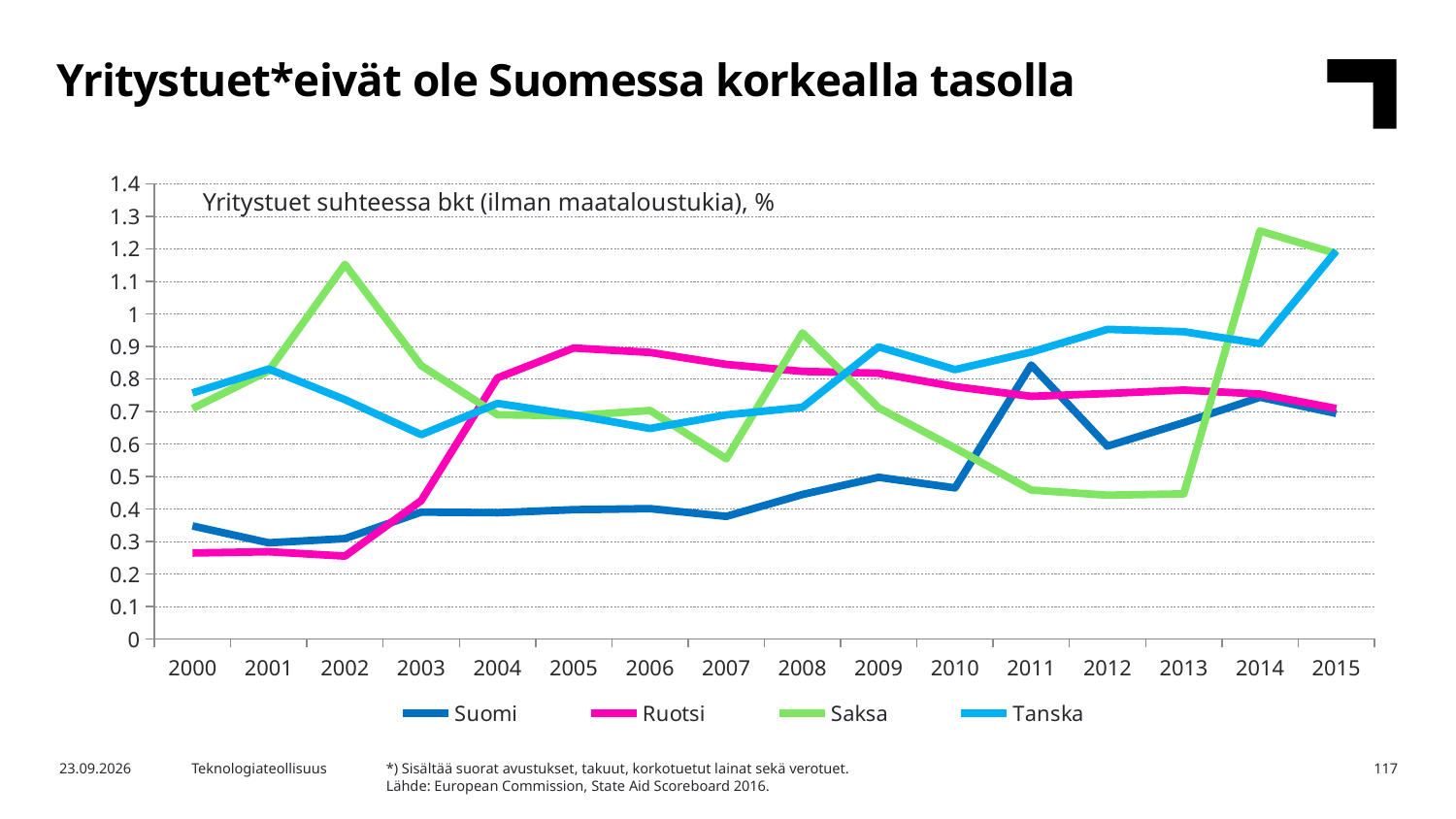
What is the title printed inside the chart area? Yritystuet suhteessa bkt (ilman maataloustukia), % How many series does the legend list? 4 What kind of chart is shown on the slide? Line chart Is the value for Saksa in 2002 greater or less than 1? greater Is the value for Suomi in 2000 greater or less than 0.5? less Which colour is used for the Saksa line? Green Which country has the lowest value in 2013? Saksa Which country has the highest value in 2002? Saksa How many years are shown on the x axis? 16 Which country has the lowest value in 2005? Suomi Which country has the highest value in 2014? Saksa In 2010, which is larger, the value for Tanska or the value for Saksa? Tanska